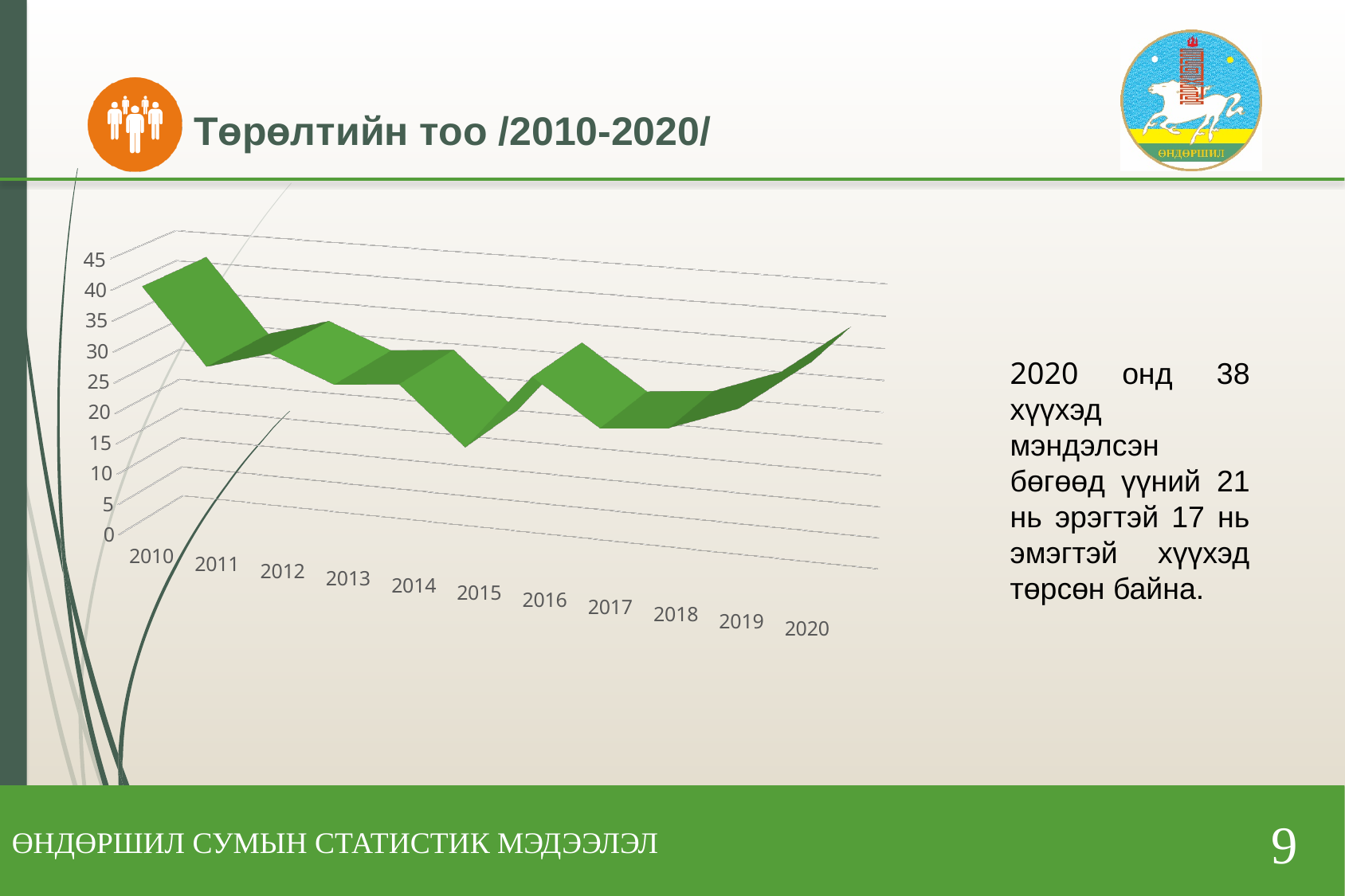
Is the value for 2010 greater or less than 30? greater Which year has the highest value in the chart? 2010 Which year has the lowest value in the chart? 2015 What is the first year shown on the x axis of the chart? 2010 What kind of chart is shown on the slide? line chart How many years are shown on the x axis of the chart? 11 Do the values rise or fall from 2018 to 2020? rise Which is larger, the value for 2010 or the value for 2015? 2010 Which is larger, the value for 2010 or the value for 2017? 2010 Is the value for 2015 greater or less than 30? less Do the values rise or fall from 2010 to 2015? fall What is the title of the chart? Төрөлтийн тоо /2010-2020/